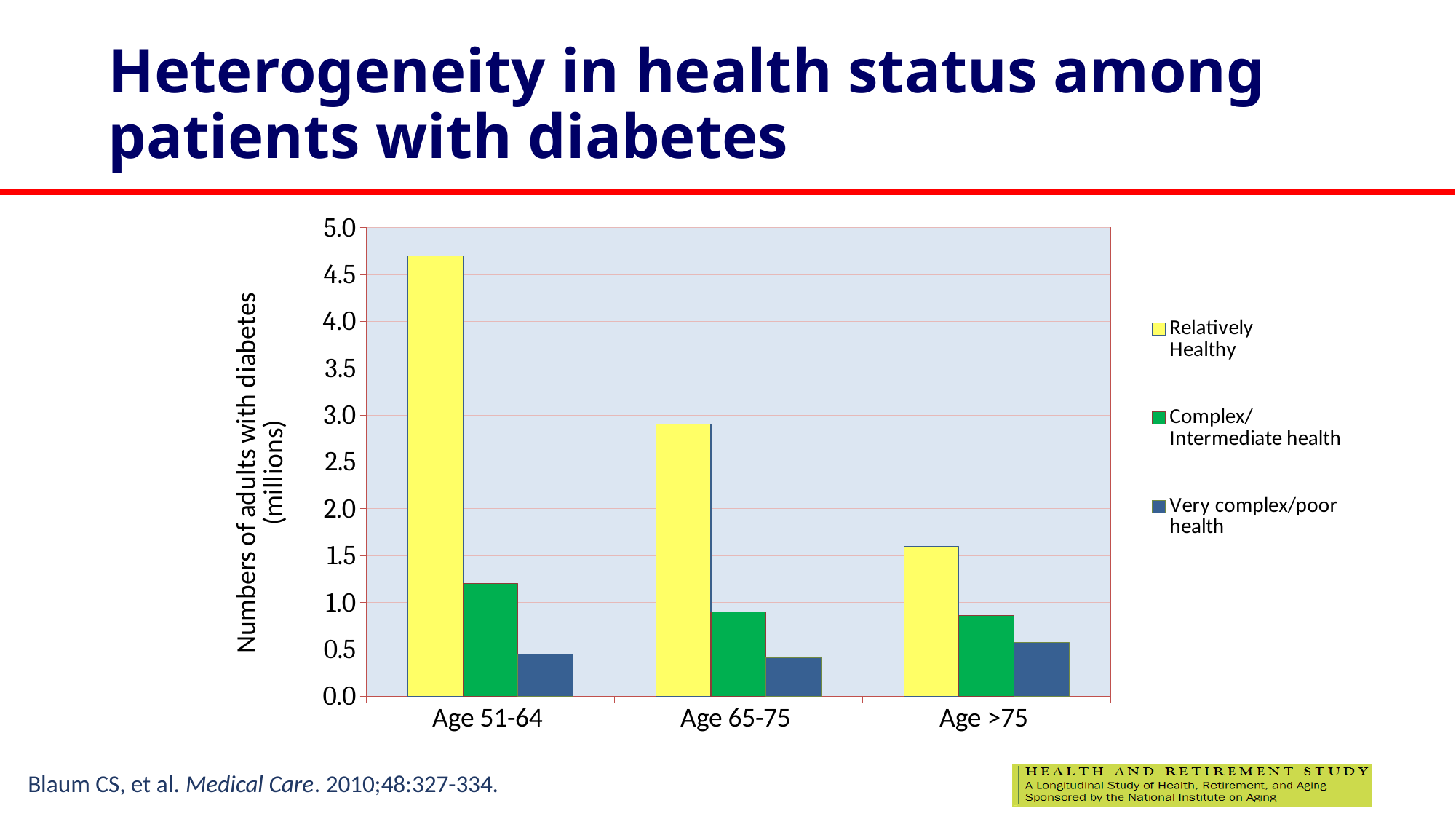
How many age groups are shown on the x axis of the chart? 3 Is the Relatively Healthy value for Age 65-75 greater or less than 2.5? greater Does the Relatively Healthy series rise or fall as the age groups move from Age 51-64 to Age >75? Fall Which is larger for Age 65-75: the Relatively Healthy bar or the Complex/Intermediate health bar? Relatively Healthy Which age group has the highest Relatively Healthy bar? Age 51-64 Which age group has the lowest Relatively Healthy bar? Age >75 Is the Complex/Intermediate health value for Age 51-64 greater or less than 1.0? greater Is the Relatively Healthy value for Age >75 greater or less than 2.0? less What kind of chart is shown on the slide? Bar chart What is the label on the chart's vertical axis? Numbers of adults with diabetes (millions) How many series does the chart's legend list? 3